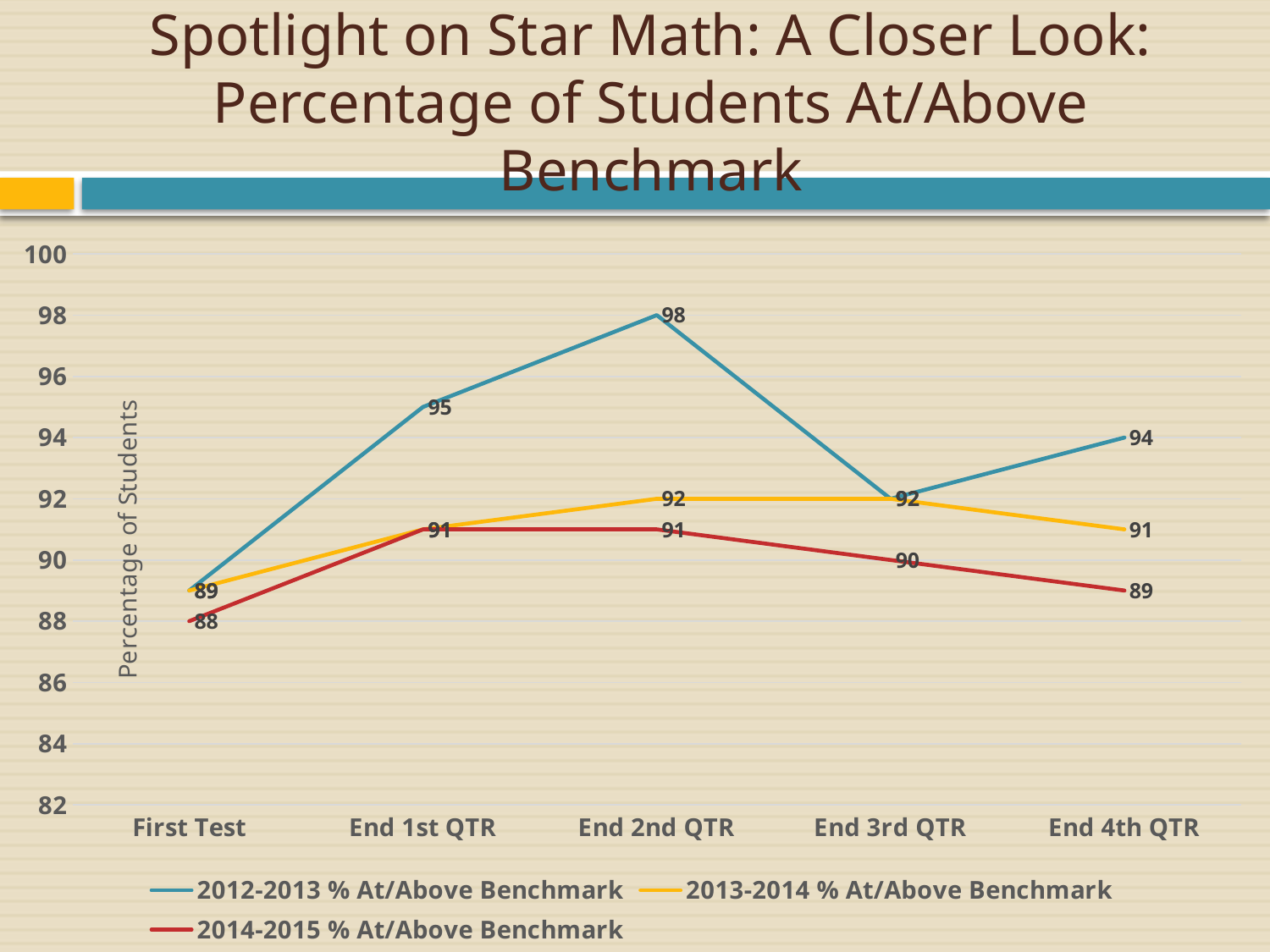
What is the difference between the 2012-2013 and 2014-2015 values at End 2nd QTR? 7 What type of chart is shown on the slide? line chart How many series does the legend list? 3 At which point on the x axis does the 2012-2013 % At/Above Benchmark series reach its highest value? End 2nd QTR How many points are plotted along the x axis for each series? 5 What is the value for 2014-2015 % At/Above Benchmark at First Test? 88 What is the value for 2012-2013 % At/Above Benchmark at End 1st QTR? 95 Which series has the larger value at End 4th QTR, 2012-2013 or 2014-2015? 2012-2013 % At/Above Benchmark What is the value for 2013-2014 % At/Above Benchmark at End 4th QTR? 91 What is the value for 2014-2015 % At/Above Benchmark at End 4th QTR? 89 What is the value for 2012-2013 % At/Above Benchmark at End 2nd QTR? 98 What is the label of the y axis? Percentage of Students